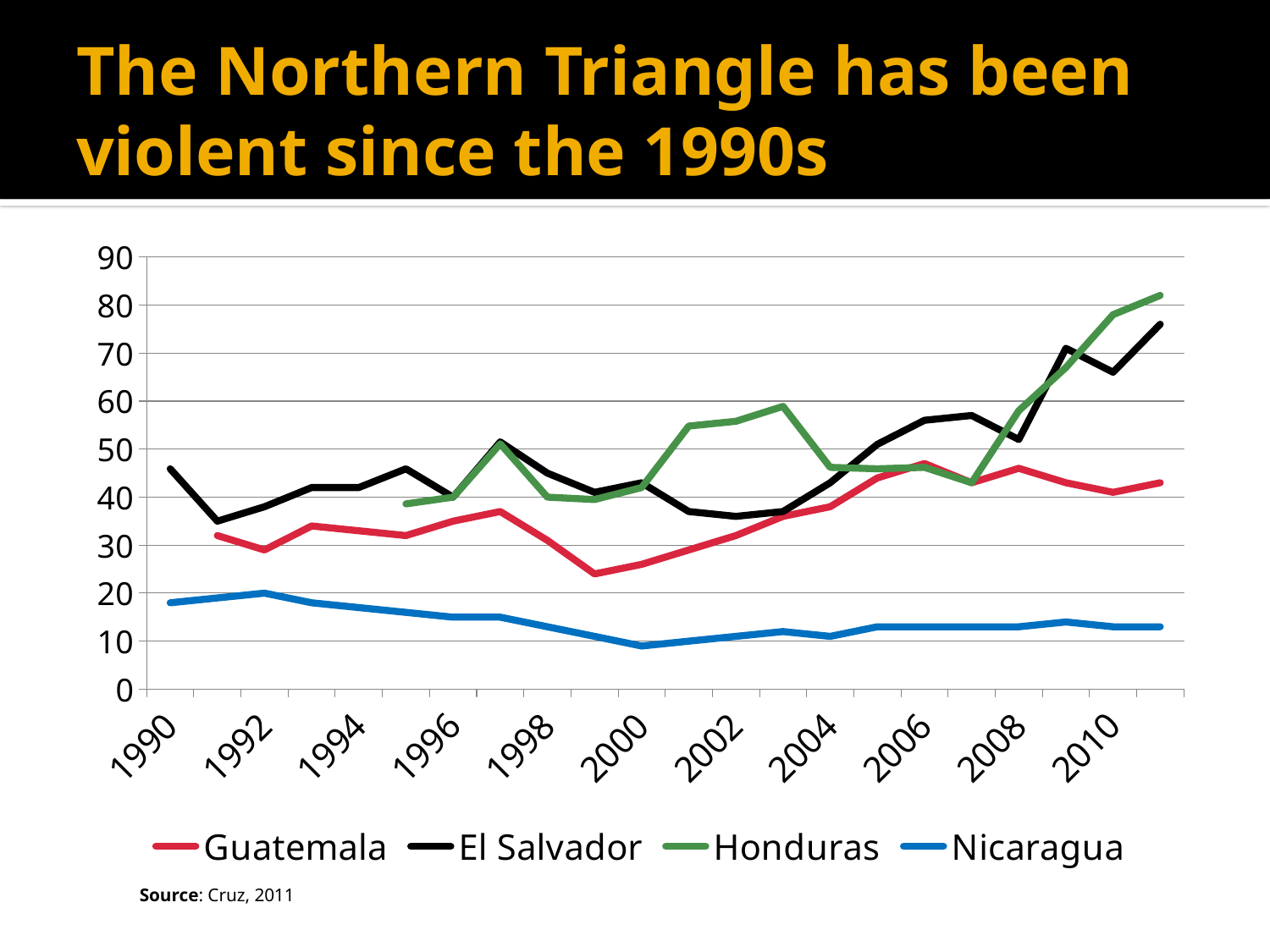
How many series does the legend list? 4 Which series reaches the highest value on the chart? Honduras What kind of chart is shown on the slide? line chart In 2008, which is larger: the value for Guatemala or the value for Nicaragua? Guatemala Is the value for Nicaragua in 2010 greater or less than 20? less What source is cited below the chart? Cruz, 2011 Is the value for Honduras in 2010 greater or less than 70? greater Does the Nicaragua line rise or fall from 1990 to 2000? fall Which series has the lowest values across the whole period shown? Nicaragua Is the value for El Salvador in 1990 greater or less than 40? greater